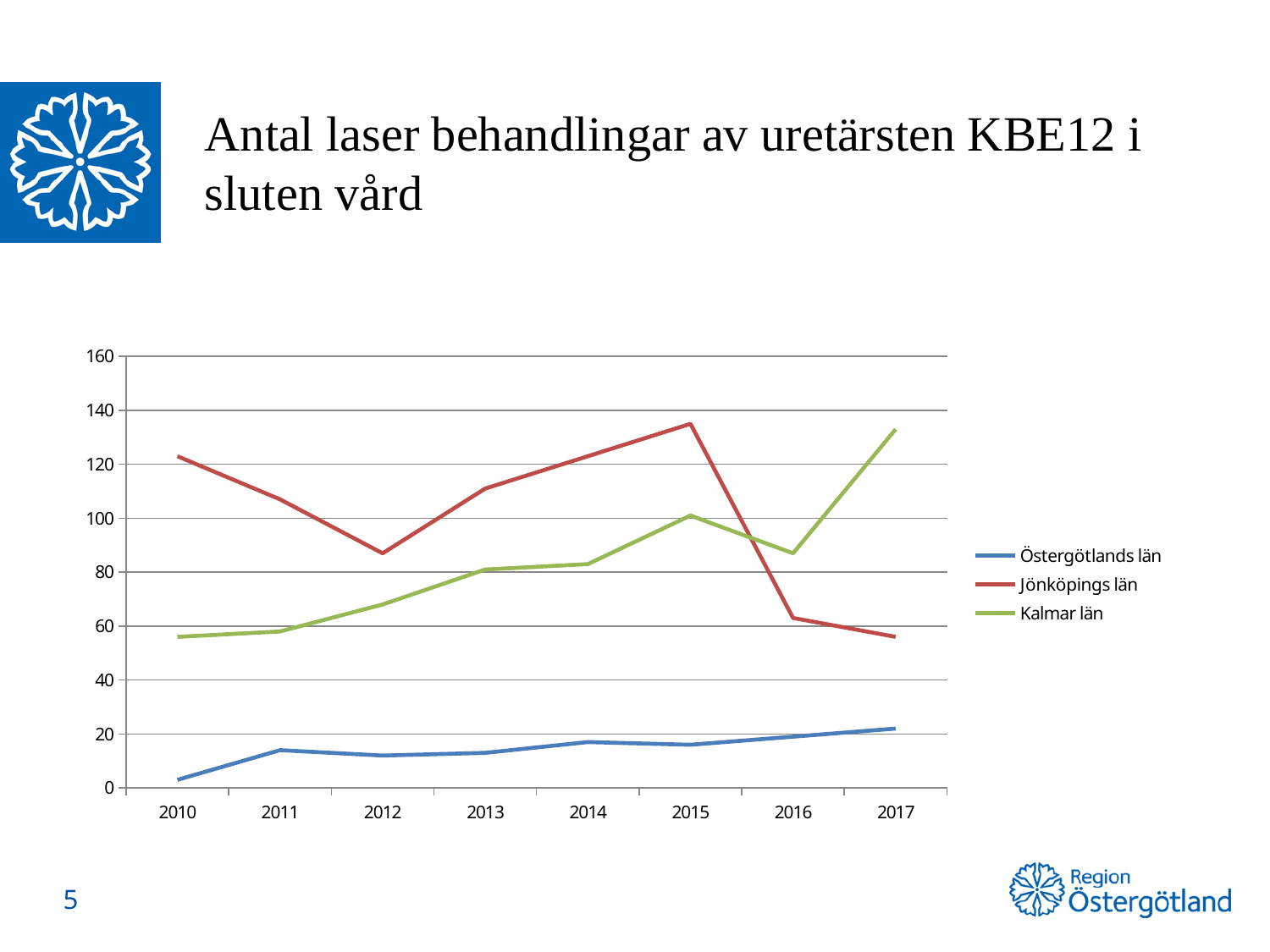
Does the Kalmar län line rise or fall from 2010 to 2015? rise In 2012, which series has the larger value, Jönköpings län or Kalmar län? Jönköpings län Which series has the lowest value in 2014? Östergötlands län Is the value for Kalmar län in 2010 greater or less than 80? less Is the value for Kalmar län in 2017 greater or less than 120? greater What kind of chart is shown on the slide? line chart Is the value for Östergötlands län in 2017 greater or less than 40? less In which year does Jönköpings län reach its highest value? 2015 How many series does the legend list? 3 In 2017, which series has the larger value, Kalmar län or Jönköpings län? Kalmar län How many years are shown on the x axis? 8